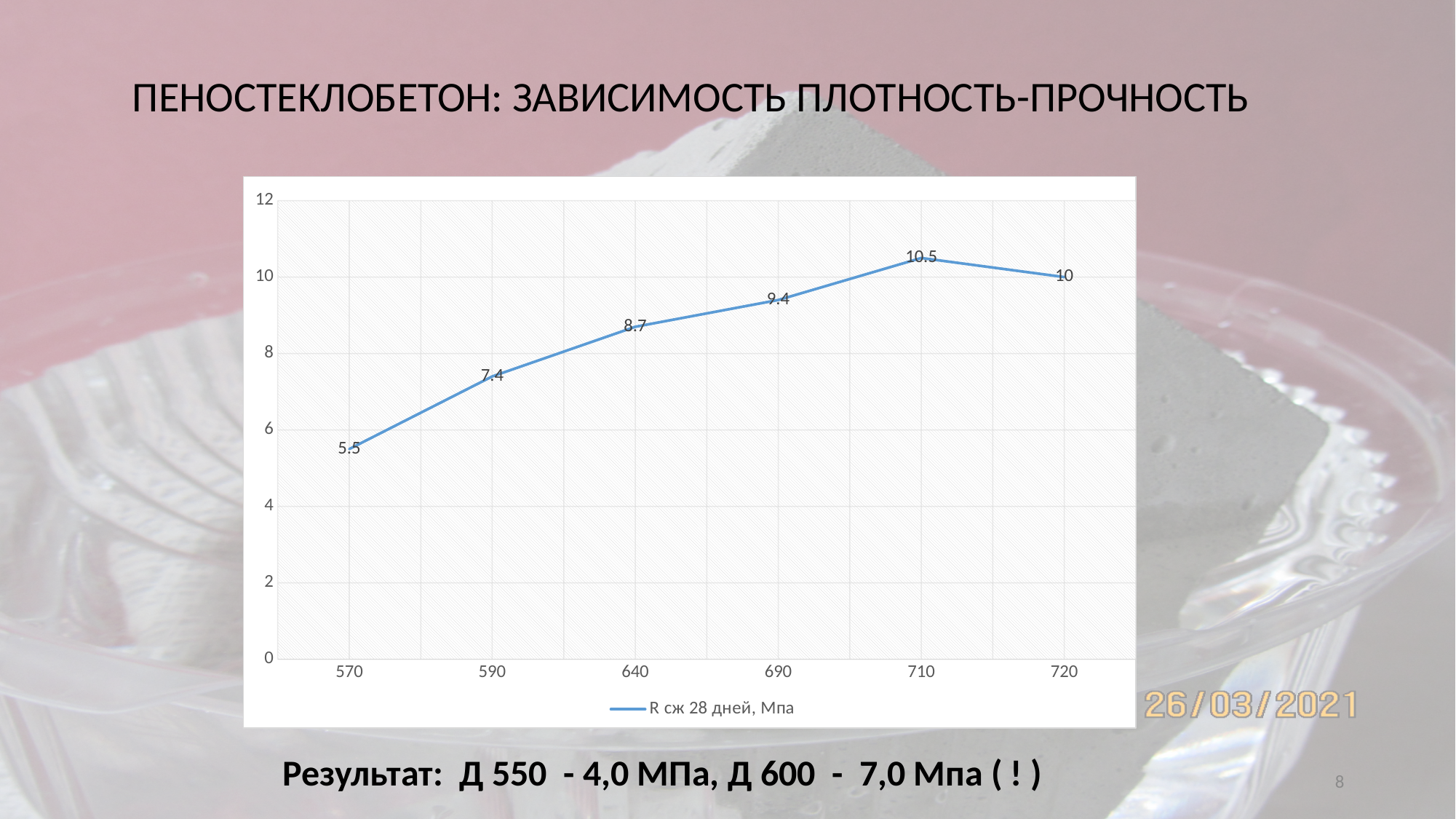
Which is larger, the value for 590 or the value for 640? 640 What is the value for 690? 9.4 How many data points are plotted on the chart? 6 Which category has the highest value? 710 What is the value for 570? 5.5 What is the difference between the values for 710 and 720? 0.5 Which category has the lowest value? 570 Is the value for 690 greater or less than 8? greater What is the value for 720? 10 What kind of chart is shown on the slide? line chart What is the name of the series shown in the legend? R сж 28 дней, Мпа What is the difference between the values for 640 and 590? 1.3